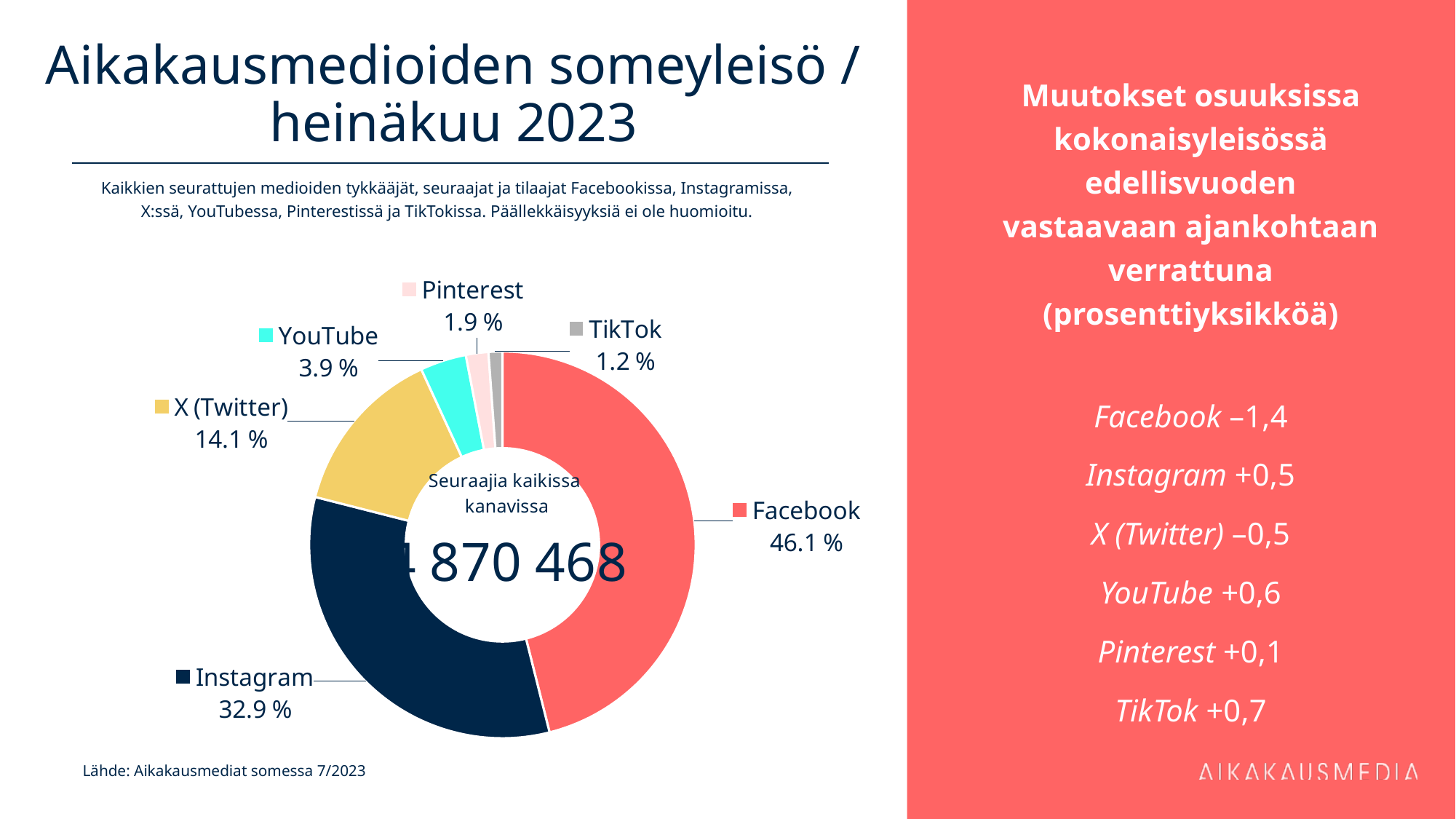
Which channel has the largest share of the audience? Facebook What percentage is shown for Instagram? 32.9 % What share of the social media audience does Facebook hold? 46.1 % Which has a larger share, YouTube or Pinterest? YouTube What type of chart is used on the slide? Pie (donut) chart How many channels are shown in the chart? 6 What is the value shown for X (Twitter)? 14.1 % What is the value shown for Pinterest? 1.9 % What percentage is shown for YouTube? 3.9 % What colour is the Facebook segment of the chart? Red What is the difference in percentage points between Facebook and Instagram? 13.2 Which channel has the smallest share of the audience? TikTok